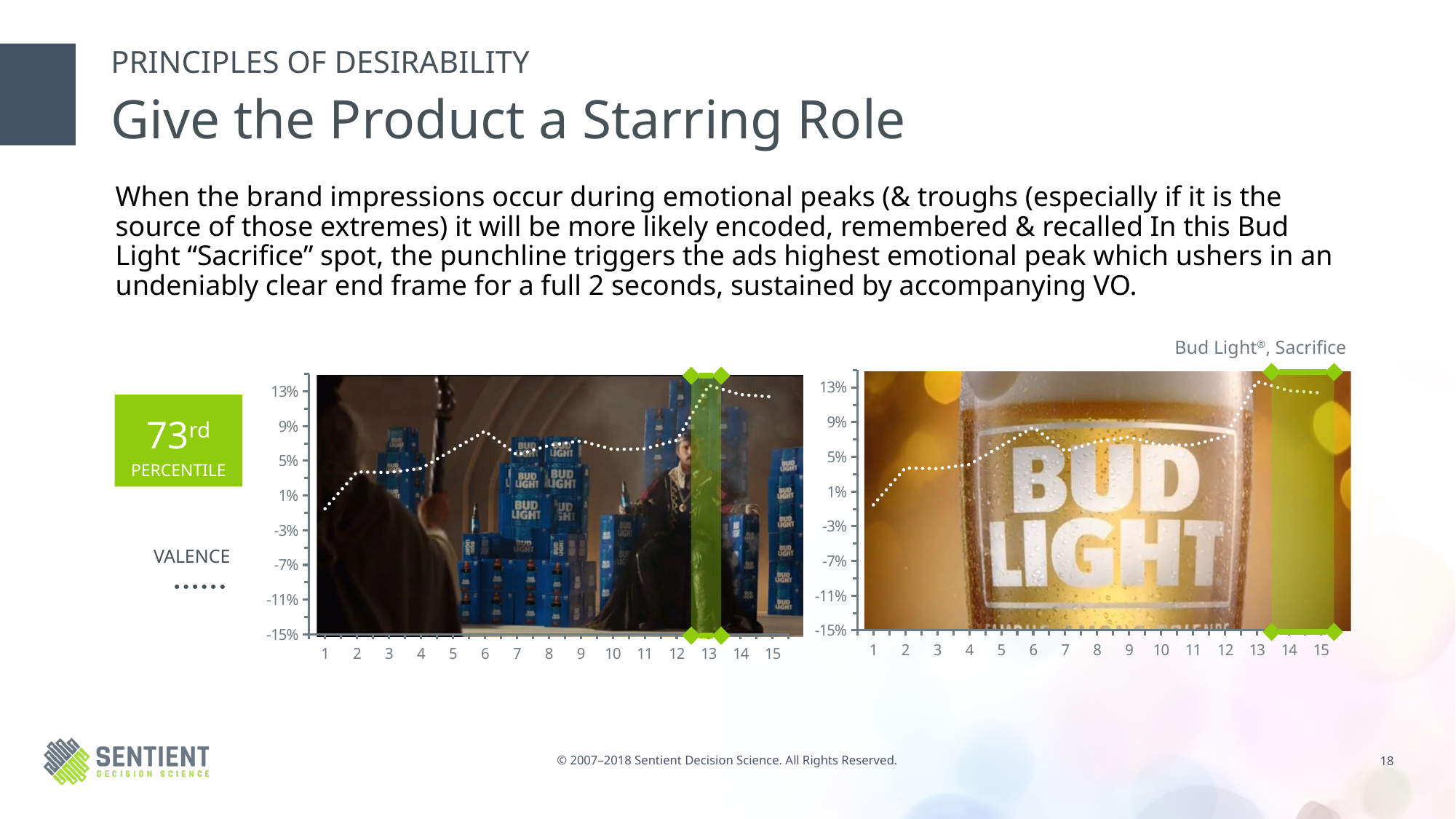
Overall, does the valence line in the right chart rise or fall from point 1 to point 15? rise How many points are plotted along the x axis of the right chart? 15 In the right chart, is the value at point 2 greater or less than 5%? less What kind of chart is the left chart on the slide? line chart What is the title shown above the right chart? Bud Light®, Sacrifice In the right chart, is the value at point 1 greater or less than 5%? less What measure does the dotted line in the charts represent, according to the legend on the left? VALENCE In the left chart, which is larger, the value at point 13 or the value at point 1? point 13 In the left chart, is the value at point 15 greater or less than 9%? greater In the left chart, which x-axis point has the lowest valence value? 1